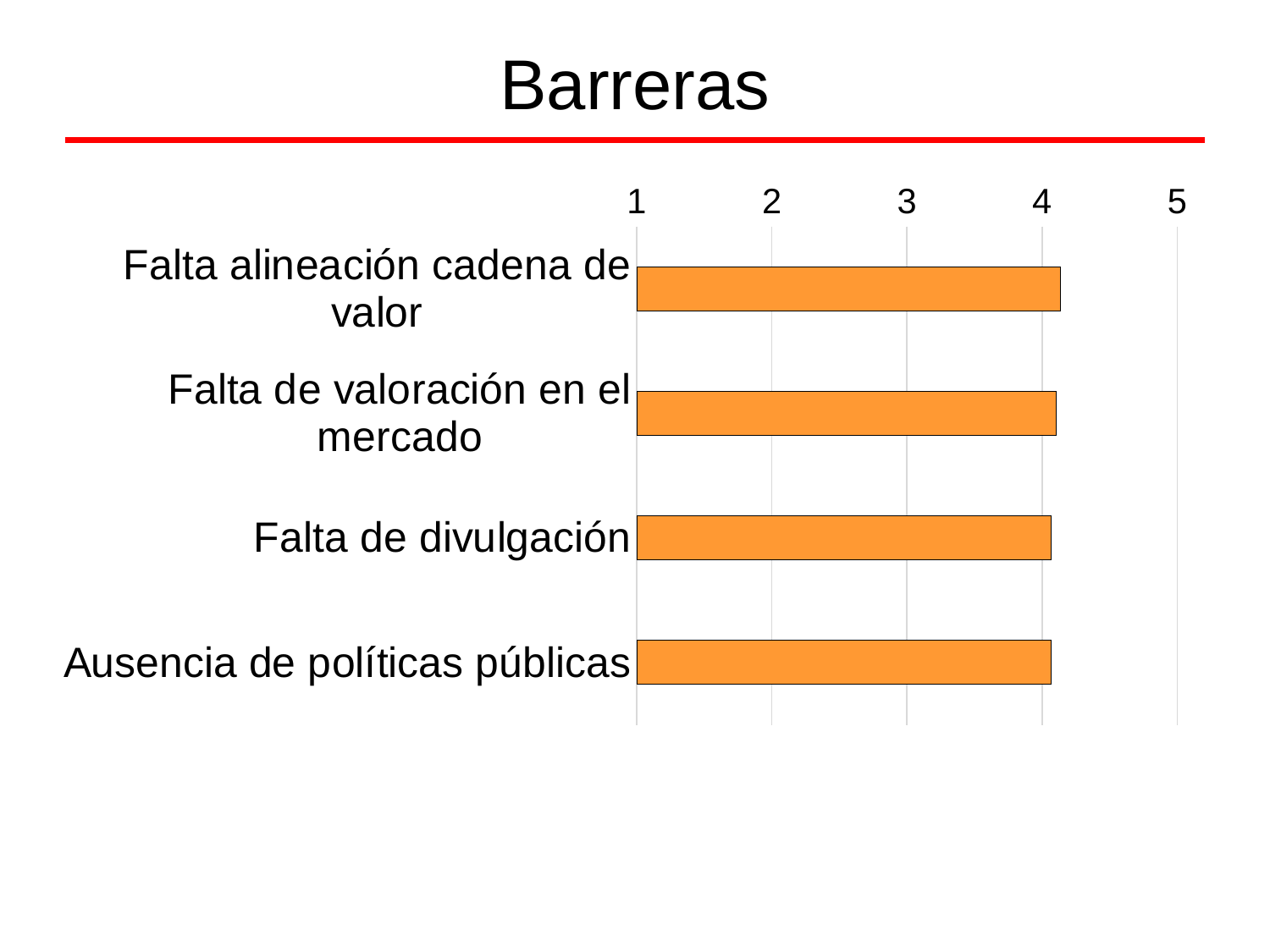
What colour are the bars in the chart? orange Is the value for "Falta alineación cadena de valor" greater or less than 3? greater Is the value for "Falta de divulgación" greater or less than 3? greater Is the value for "Ausencia de políticas públicas" greater or less than 5? less How many categories (barriers) are plotted in the chart? 4 What is the title of the slide containing the chart? Barreras What kind of chart is shown on the slide? bar chart What is the highest value shown on the horizontal axis of the chart? 5